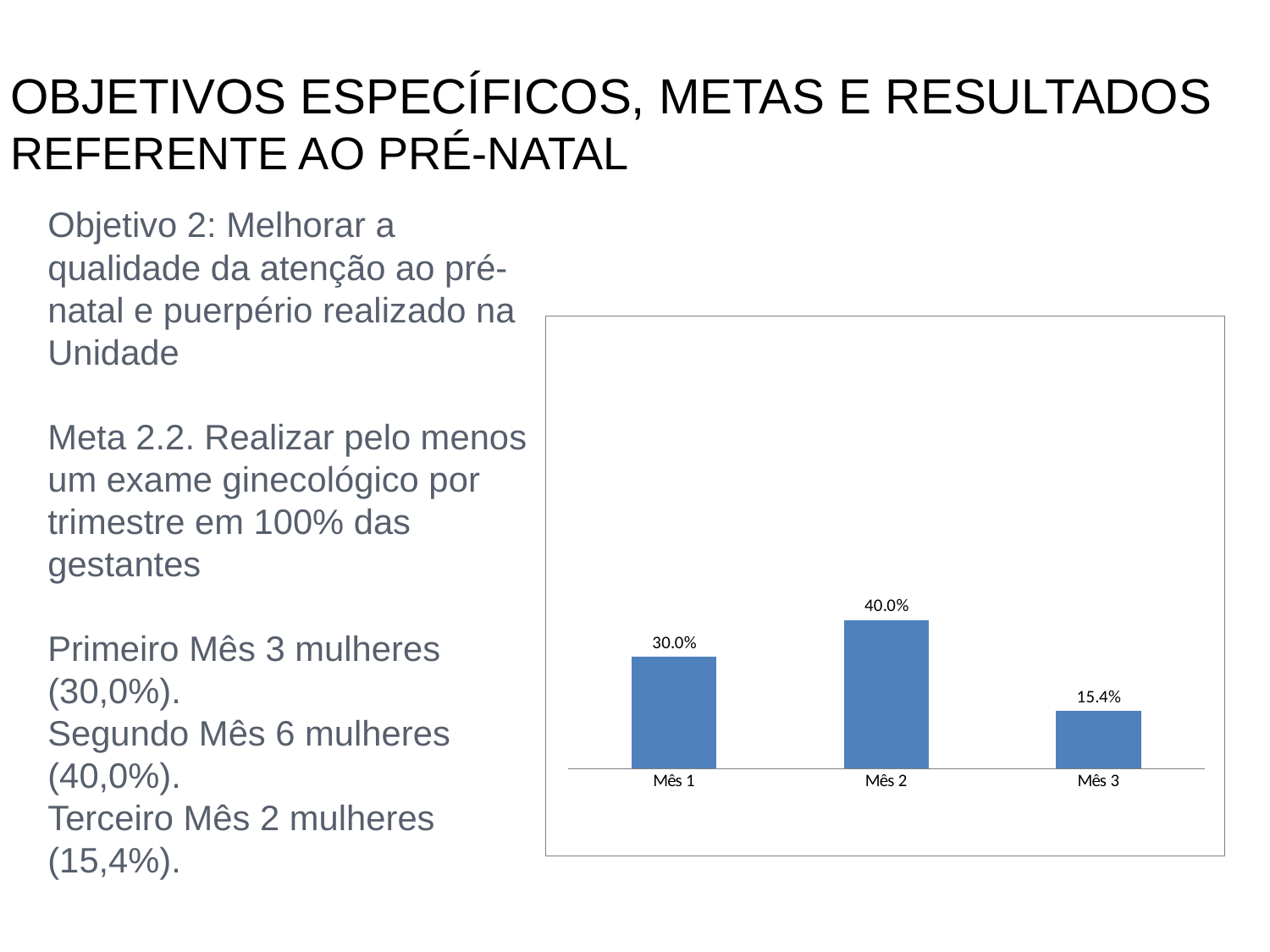
What is the value for Mês 1? 30.0% What is the value for Mês 2? 40.0% What kind of chart is shown on the slide? Bar chart What colour are the bars in the chart? Blue What is the difference between the values for Mês 2 and Mês 3? 24.6% Which month has the lowest value? Mês 3 What is the difference between the values for Mês 2 and Mês 1? 10.0% Which is larger, the value for Mês 1 or the value for Mês 3? Mês 1 Do the values rise or fall from Mês 2 to Mês 3? Fall How many categories are shown on the x axis of the chart? 3 Which month has the highest value? Mês 2 What is the value for Mês 3? 15.4%